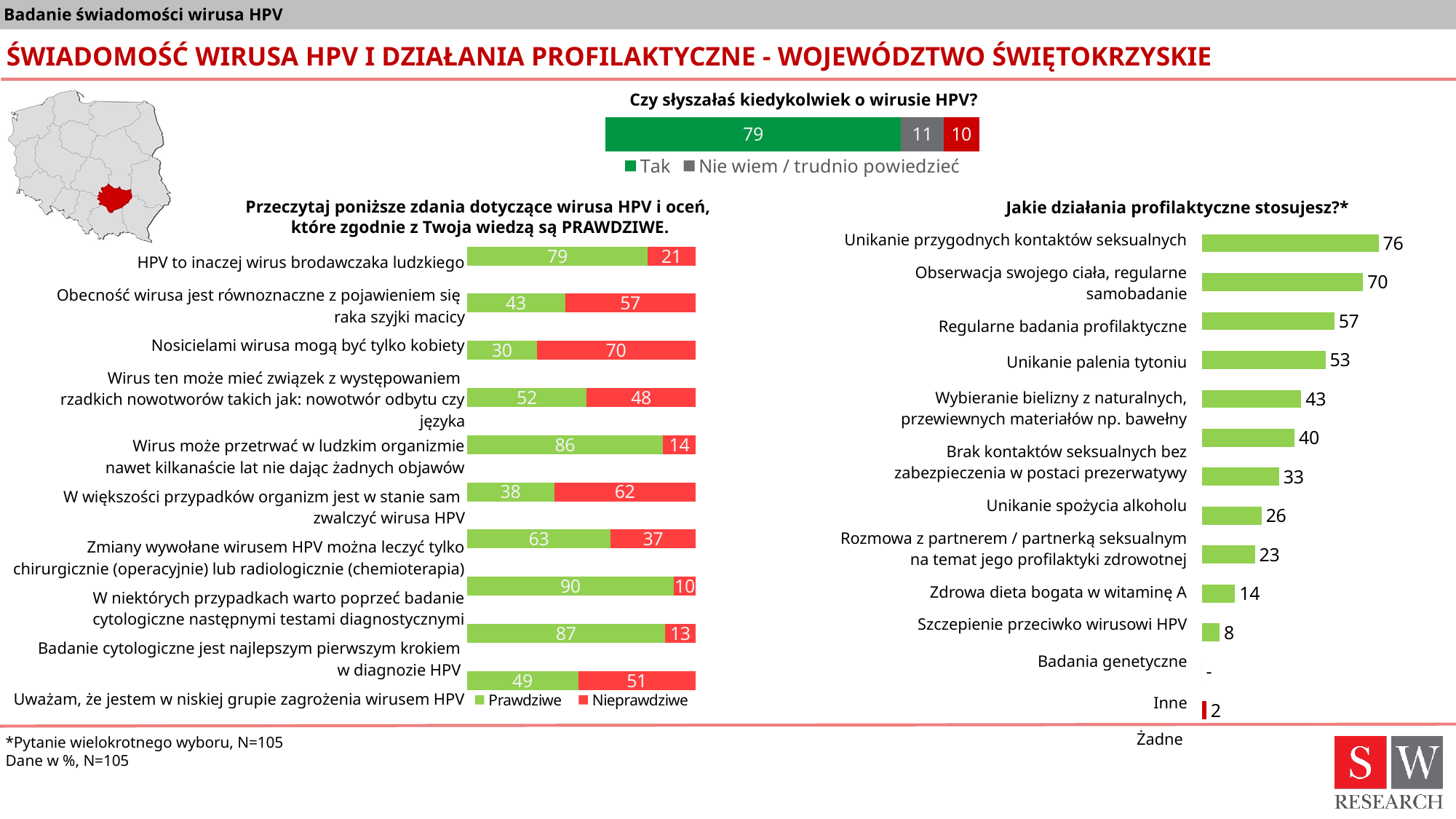
In the chart 'Jakie działania profilaktyczne stosujesz?*', which category has the highest value? Unikanie przygodnych kontaktów seksualnych In the chart 'Przeczytaj poniższe zdania dotyczące wirusa HPV...', what is the 'Nieprawdziwe' value for 'Nosicielami wirusa mogą być tylko kobiety'? 70 In the chart 'Czy słyszałaś kiedykolwiek o wirusie HPV?', what is the total of the stacked bar? 100 In the chart 'Przeczytaj poniższe zdania dotyczące wirusa HPV...', what kind of chart is it? Stacked bar chart In the chart 'Jakie działania profilaktyczne stosujesz?*', which is larger: 'Obserwacja swojego ciała, regularne samobadanie' or 'Unikanie palenia tytoniu'? Obserwacja swojego ciała, regularne samobadanie In the chart 'Przeczytaj poniższe zdania dotyczące wirusa HPV...', how many series does the legend list? 2 In the chart 'Czy słyszałaś kiedykolwiek o wirusie HPV?', what is the value for 'Nie wiem / trudnio powiedzieć'? 11 In the chart 'Jakie działania profilaktyczne stosujesz?*', what is the value for 'Unikanie przygodnych kontaktów seksualnych'? 76 In the chart 'Czy słyszałaś kiedykolwiek o wirusie HPV?', what is the value for 'Tak'? 79 In the chart 'Jakie działania profilaktyczne stosujesz?*', what is the difference between 'Unikanie przygodnych kontaktów seksualnych' and 'Unikanie palenia tytoniu'? 23 In the chart 'Przeczytaj poniższe zdania dotyczące wirusa HPV...', what is the 'Prawdziwe' value for 'HPV to inaczej wirus brodawczaka ludzkiego'? 79 In the chart 'Jakie działania profilaktyczne stosujesz?*', what is the value for 'Regularne badania profilaktyczne'? 57